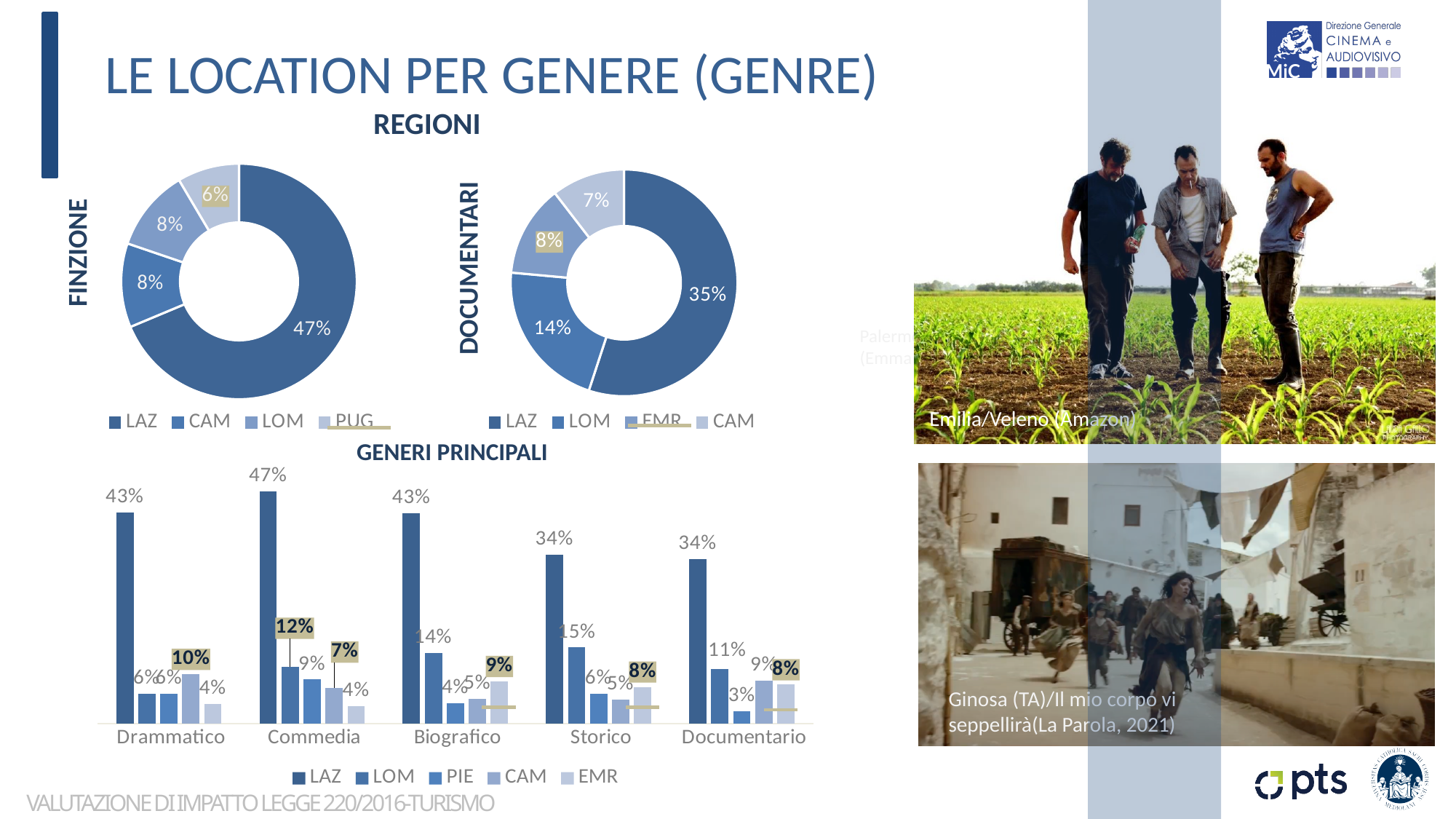
In the FINZIONE donut chart, how many regions does the legend list? 4 In the GENERI PRINCIPALI chart, what is the value for LOM in Storico? 15% In the DOCUMENTARI donut chart, which region has the smallest labelled share? CAM In the FINZIONE donut chart, what is the value for LAZ? 47% In the GENERI PRINCIPALI chart, how many series does the legend list? 5 In the GENERI PRINCIPALI chart, which is larger: LOM in Biografico or LOM in Documentario? LOM in Biografico What kind of chart is the GENERI PRINCIPALI chart? Bar chart In the GENERI PRINCIPALI chart, which genre has the highest LAZ value? Commedia In the GENERI PRINCIPALI chart, how many genres are shown on the x axis? 5 In the GENERI PRINCIPALI chart, what is the difference between the LAZ values for Commedia and Storico? 13% In the DOCUMENTARI donut chart, what is the value for LOM? 14% In the GENERI PRINCIPALI chart, what is the value for LAZ in Commedia? 47%